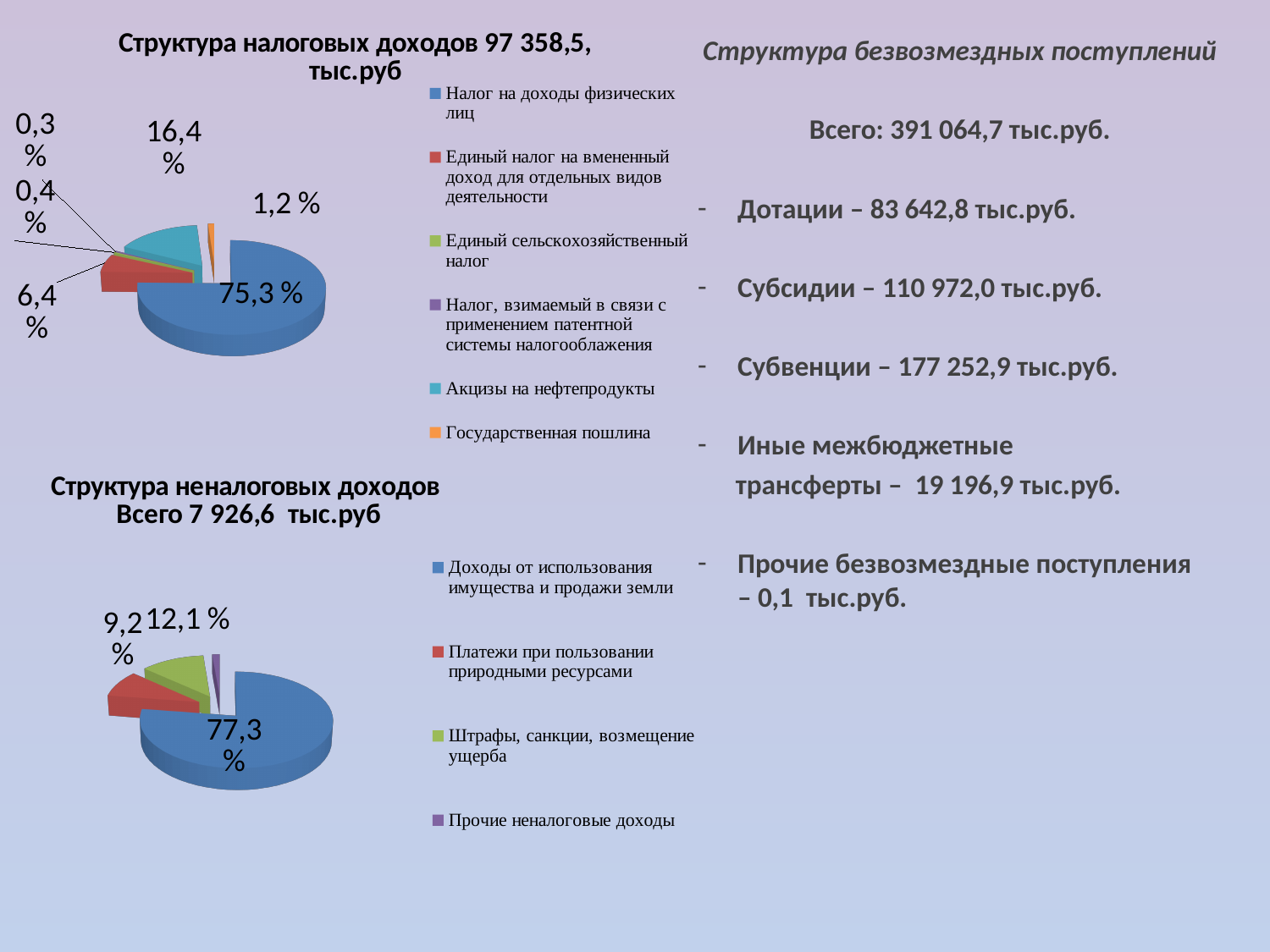
In the 'Структура налоговых доходов' chart, what share is shown for 'Налог на доходы физических лиц'? 75,3 % In the 'Структура налоговых доходов' chart, what share is shown for 'Акцизы на нефтепродукты'? 16,4 % In the 'Структура налоговых доходов' chart, what share is shown for 'Единый налог на вмененный доход для отдельных видов деятельности'? 6,4 % How many categories does the legend of the 'Структура налоговых доходов' chart list? 6 In the 'Структура налоговых доходов' chart, which is larger: 'Акцизы на нефтепродукты' or 'Единый налог на вмененный доход'? Акцизы на нефтепродукты What total amount is stated in the title of the 'Структура неналоговых доходов' chart? 7 926,6 тыс.руб What kind of chart is the 'Структура налоговых доходов' chart? pie chart How many categories does the legend of the 'Структура неналоговых доходов' chart list? 4 In the 'Структура налоговых доходов' chart, what is the difference in percentage points between 'Налог на доходы физических лиц' and 'Акцизы на нефтепродукты'? 58,9 In the 'Структура налоговых доходов' chart, which category has the largest slice? Налог на доходы физических лиц